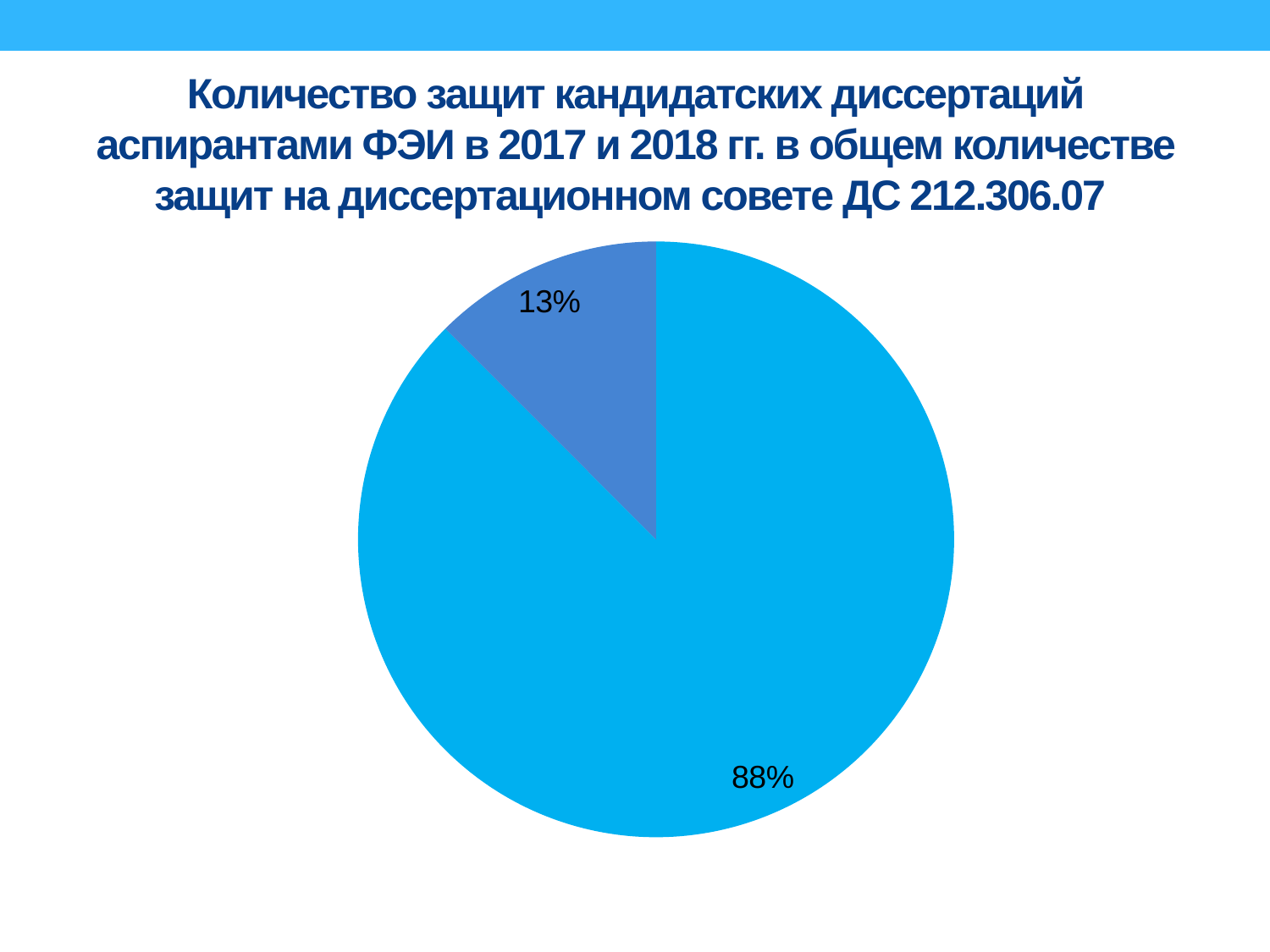
Is the share of the darker blue slice greater or less than 50%? less What share of the pie does the light blue slice represent? 88% Which slice is the largest in the pie chart, the light blue one or the darker blue one? the light blue one Which dissertation council number is mentioned in the chart title? ДС 212.306.07 How many slices does the pie chart have? 2 What share of the pie does the darker blue slice represent? 13% Is the light blue slice larger or smaller than the darker blue slice? larger What is the difference in percentage points between the light blue slice and the darker blue slice? 75 What kind of chart is shown on the slide? pie chart Which years are mentioned in the chart title? 2017 и 2018 Which slice is the smallest in the pie chart, the light blue one or the darker blue one? the darker blue one